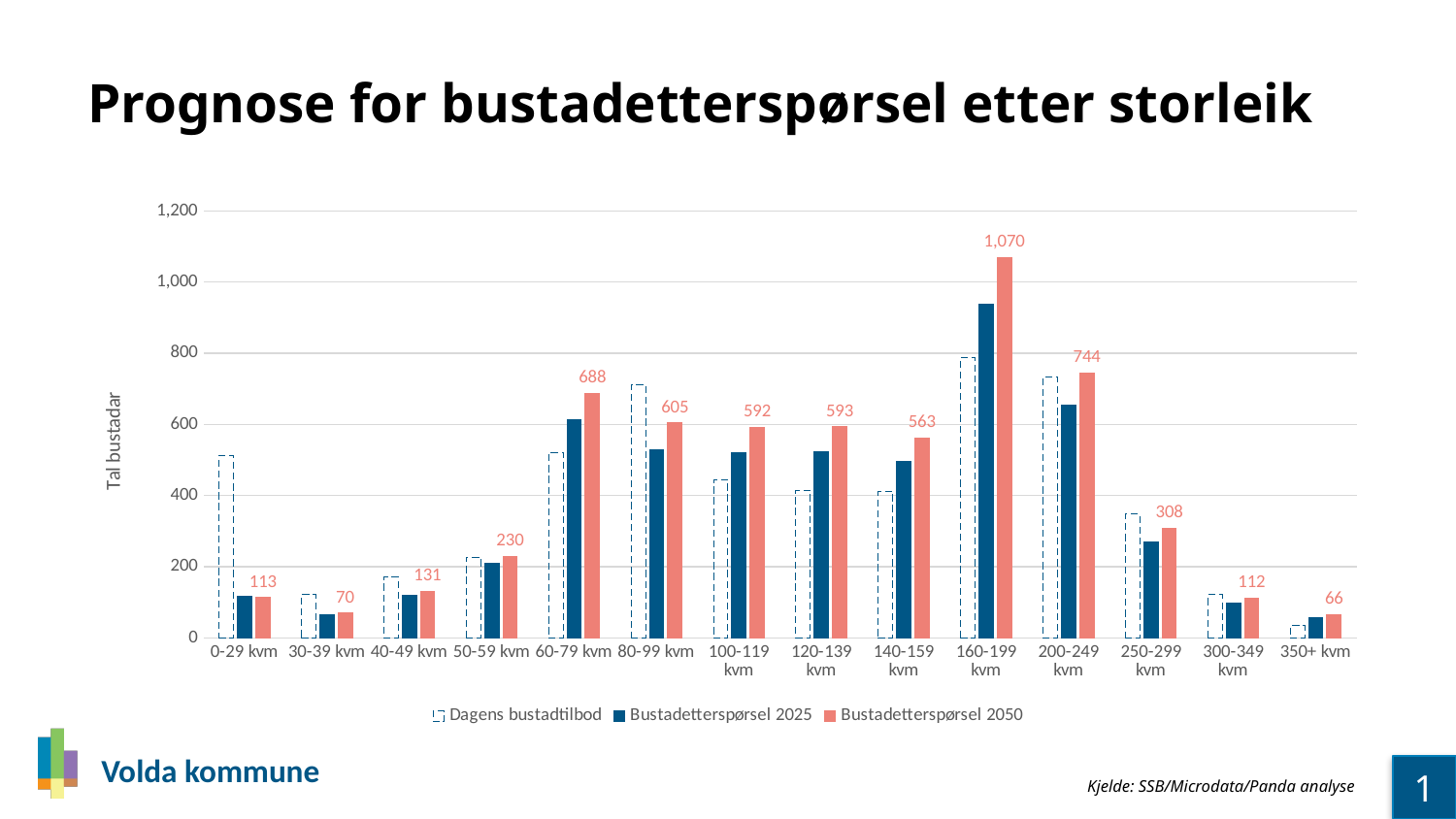
Which is larger, the Bustadetterspørsel 2050 value for 80-99 kvm or for 100-119 kvm? 80-99 kvm What is the Bustadetterspørsel 2050 value for the 350+ kvm category? 66 What is the Bustadetterspørsel 2050 value for the 60-79 kvm category? 688 Which category has the highest Bustadetterspørsel 2050 value? 160-199 kvm Is the Bustadetterspørsel 2025 value for 160-199 kvm greater or less than 800? greater What kind of chart is shown on the slide? Bar chart How many series does the legend list? 3 Is the Dagens bustadtilbod value for 0-29 kvm greater or less than 400? greater What is the difference between the Bustadetterspørsel 2050 values for 160-199 kvm and 200-249 kvm? 326 What is the Bustadetterspørsel 2050 value for the 160-199 kvm category? 1,070 How many size categories are shown on the x axis? 14 Which category has the lowest Bustadetterspørsel 2050 value? 350+ kvm